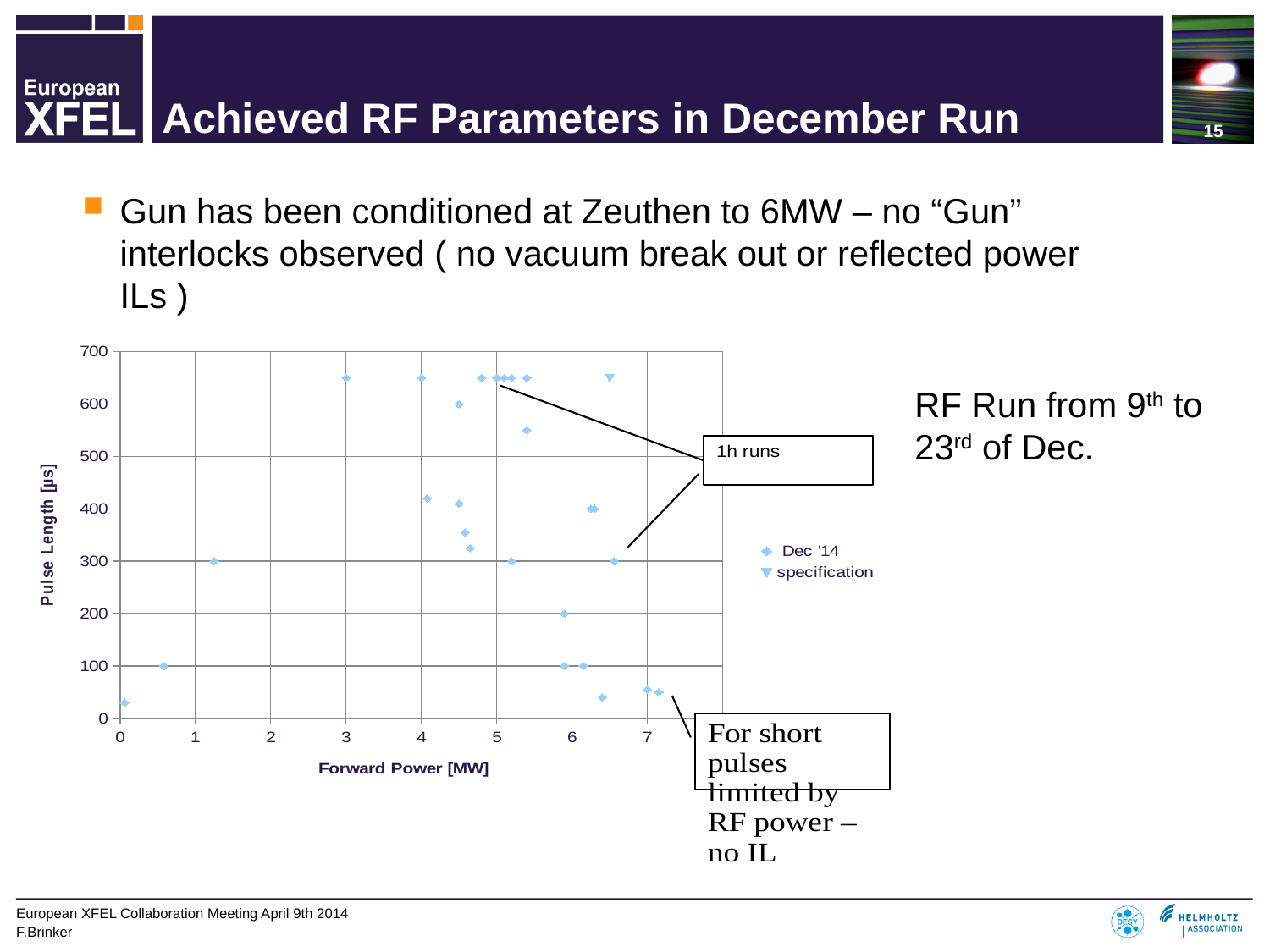
What kind of chart is shown on the slide? scatter chart Is the forward power of the specification point greater or less than 6? greater Is the pulse length of the specification point greater or less than 600? greater How many series does the chart legend list? 2 Is the maximum pulse length reached by the Dec '14 series greater or less than 600? greater What is the title of the x axis of the chart? Forward Power [MW] What are the two series named in the chart legend? Dec '14 and specification